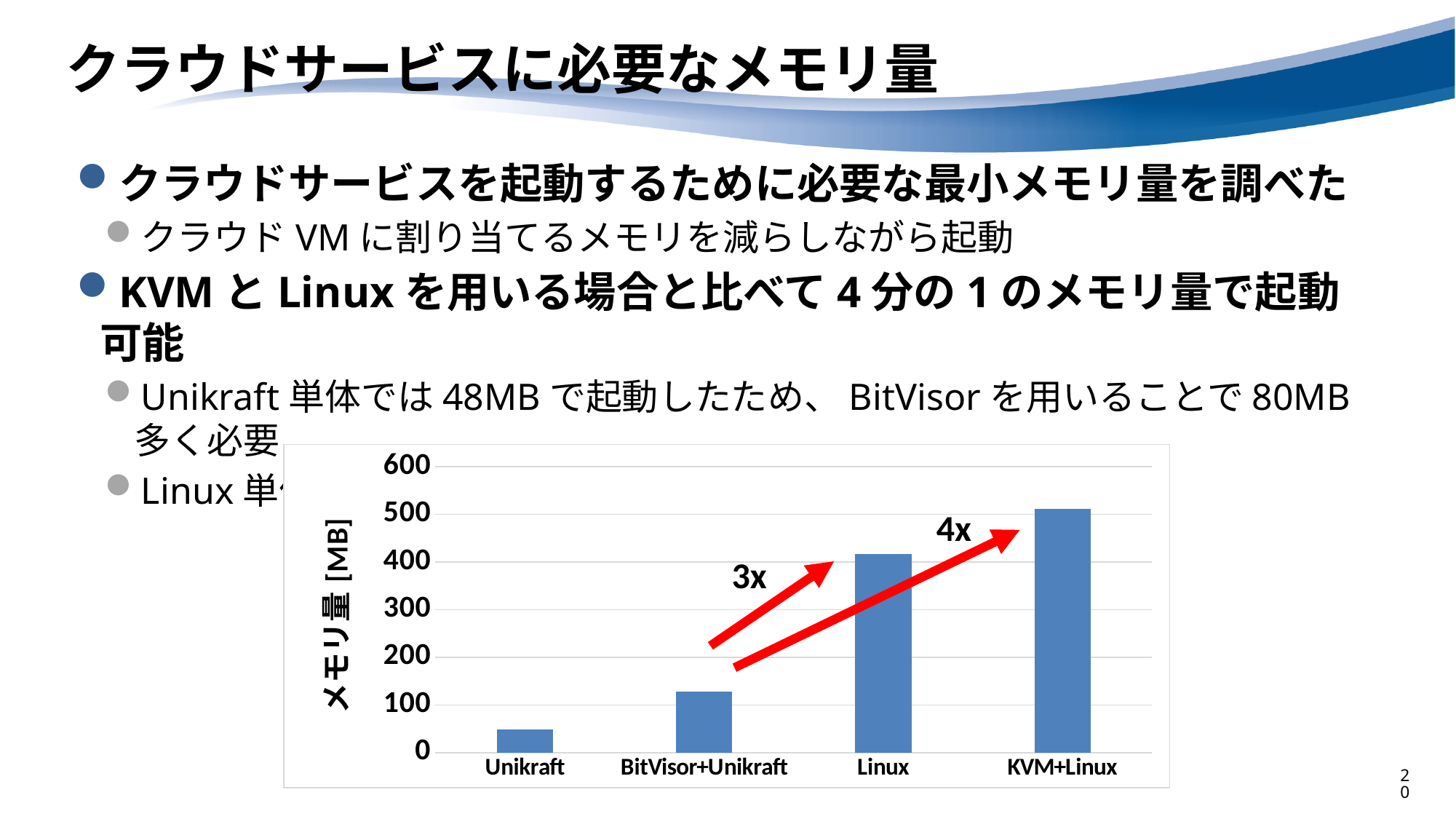
Which is larger, the value for Linux or the value for BitVisor+Unikraft? Linux Is the value for BitVisor+Unikraft greater or less than 200? less How many categories are plotted on the x axis of the chart? 4 Which category has the lowest bar in the chart? Unikraft Is the value for KVM+Linux greater or less than 500? greater Which category has the highest bar in the chart? KVM+Linux What multiplier is written next to the red arrow pointing to the KVM+Linux bar? 4x What kind of chart is shown on the slide? bar chart Is the value for Linux greater or less than 400? greater What is the label of the vertical axis of the chart? メモリ量 [MB] Do the bar values rise or fall from left to right along the x axis? rise